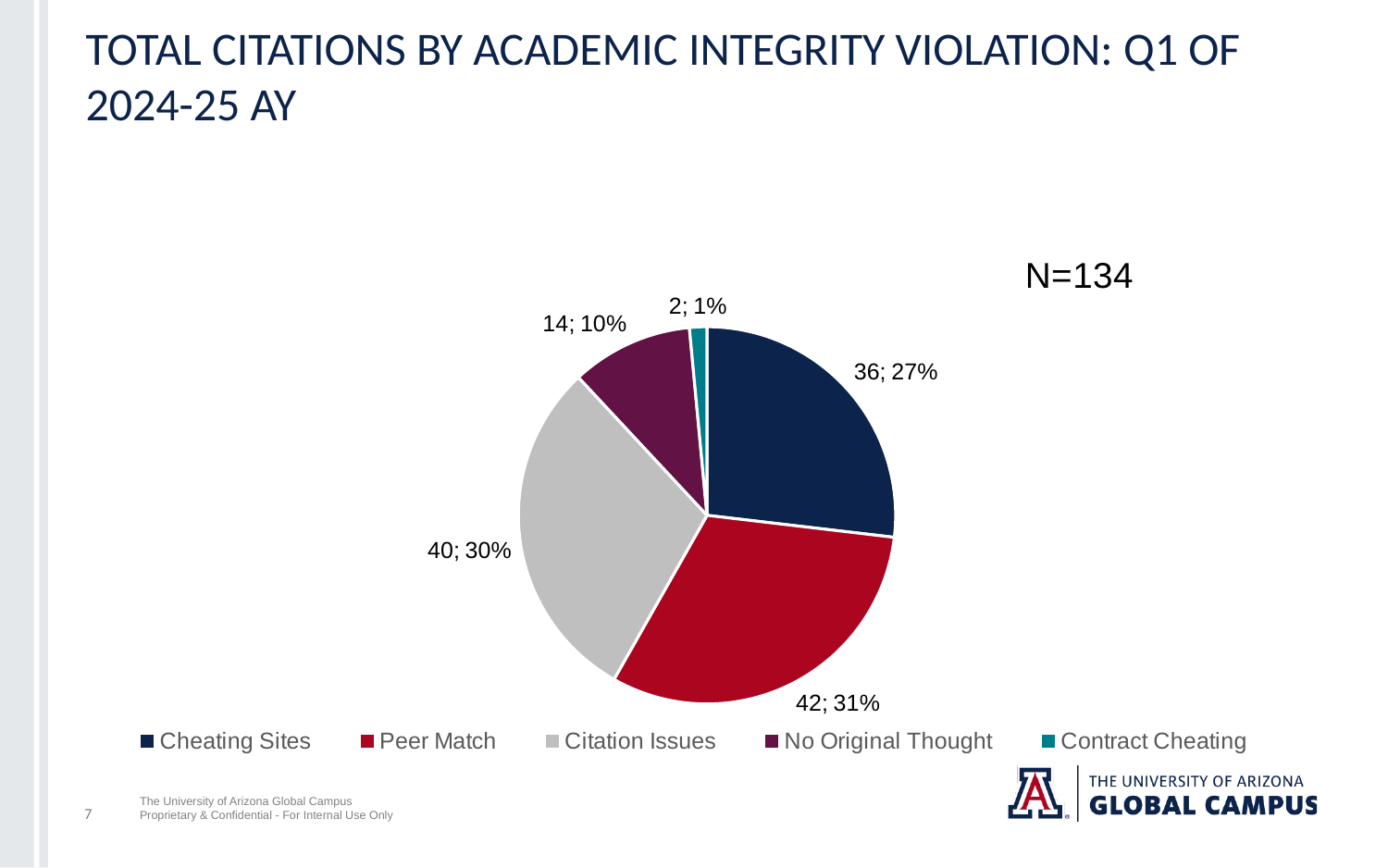
What is the total number of citations (N) stated on the slide? N=134 What percentage of citations are for Citation Issues? 30% Which legend entry is shown in red? Peer Match What type of chart is shown on the slide? Pie chart Which has more citations, Cheating Sites or Citation Issues? Citation Issues Which violation category has the most citations? Peer Match How many citations are attributed to Peer Match? 42 How many violation categories are shown in the pie chart? 5 What share of the pie does No Original Thought represent? 10% Which violation category has the fewest citations? Contract Cheating How many citations are attributed to Cheating Sites? 36 What is the difference in citations between Citation Issues and No Original Thought? 26